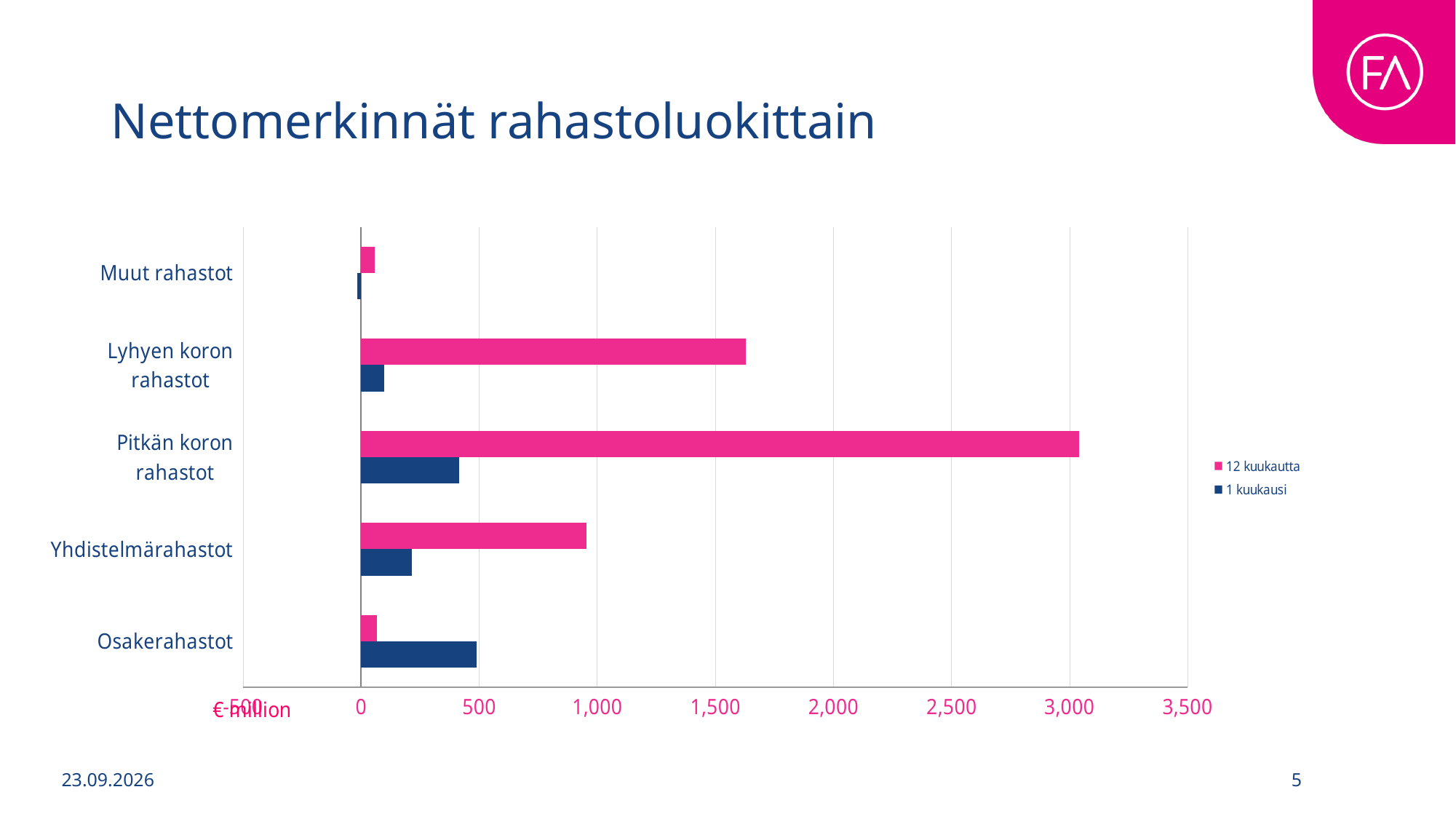
What is the title of the chart? Nettomerkinnät rahastoluokittain Which category has the lowest value for the 1 kuukausi series? Muut rahastot Is the 12 kuukautta value for Lyhyen koron rahastot greater or less than 1,500? greater How many series does the legend list? 2 How many fund categories are shown on the chart? 5 Which category has the highest value for the 1 kuukausi series? Osakerahastot Which category has the highest value for the 12 kuukautta series? Pitkän koron rahastot For Osakerahastot, which series has the larger value: 12 kuukautta or 1 kuukausi? 1 kuukausi What kind of chart is shown on the slide? bar chart Is the 12 kuukautta value for Pitkän koron rahastot greater or less than 2,500? greater Is the 12 kuukautta value for Yhdistelmärahastot greater or less than 1,000? less Which colour represents the 12 kuukautta series? pink